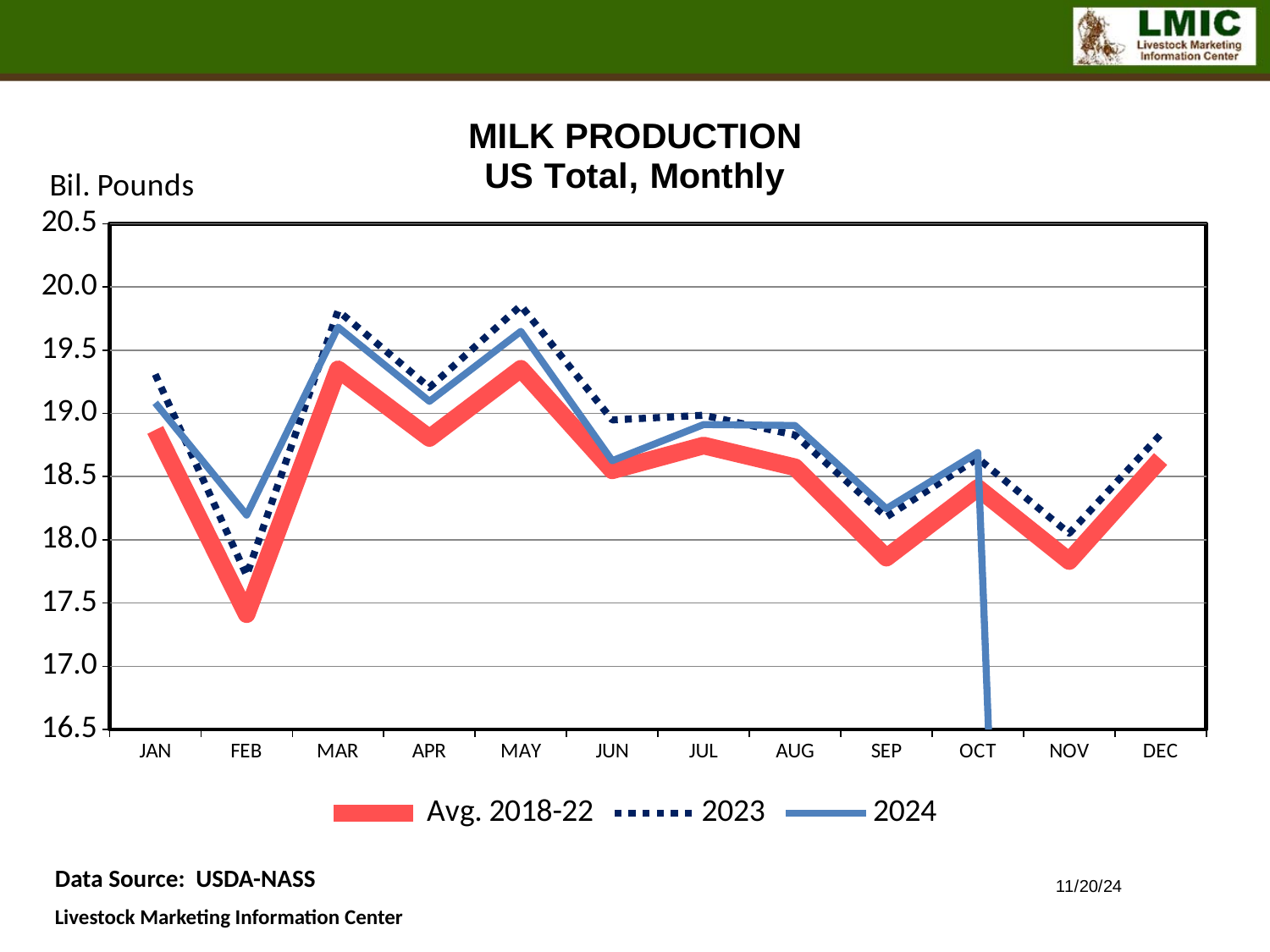
Which series has the higher value in MAY, 2023 or Avg. 2018-22? 2023 Does the 2024 series rise or fall from MAR to APR? fall In which month does the 2023 series reach its lowest value? FEB Is the 2023 value for MAY greater or less than 19.5? greater In which month does the Avg. 2018-22 series reach its lowest value? FEB How many series does the legend list? 3 Is the 2024 value for MAR greater or less than 19.5? greater What unit is shown on the y axis label? Bil. Pounds Is the 2023 value for FEB greater or less than 18.0? less How many months are shown along the x axis? 12 What kind of chart is shown on the slide? line chart In which month does the 2023 series reach its highest value? MAY